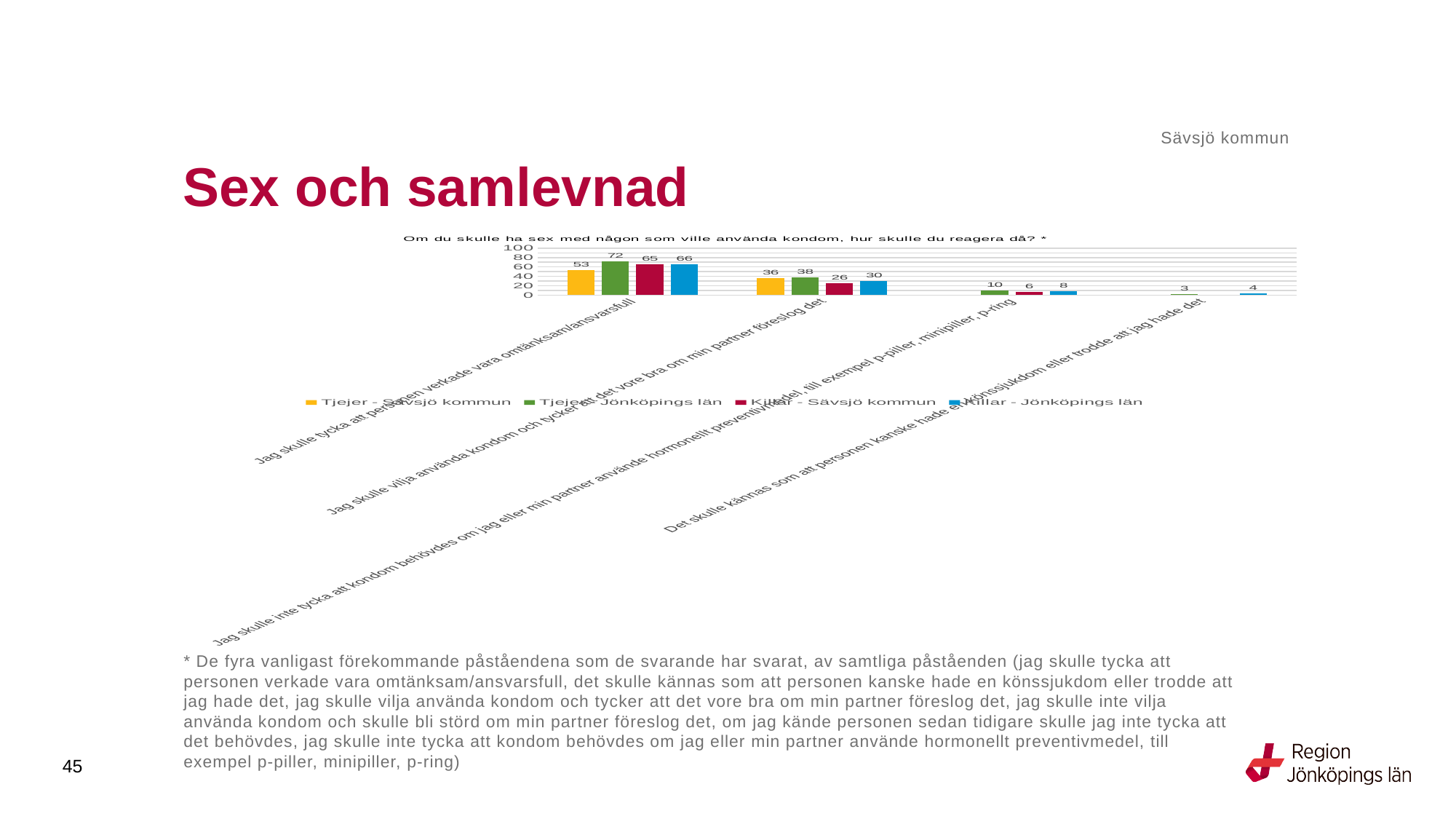
Which series has the highest value for the category "Jag skulle tycka att personen verkade vara omtänksam/ansvarsfull"? Tjejer - Jönköpings län How many series does the legend list? 4 What is the difference between Tjejer - Jönköpings län and Tjejer - Sävsjö kommun for the category "Jag skulle tycka att personen verkade vara omtänksam/ansvarsfull"? 19 Which is larger for the category "Jag skulle vilja använda kondom och tycker att det vore bra om min partner föreslog det": Tjejer - Sävsjö kommun or Killar - Jönköpings län? Tjejer - Sävsjö kommun Is the value for Killar - Jönköpings län for the category "Jag skulle tycka att personen verkade vara omtänksam/ansvarsfull" greater or less than 40? greater What kind of chart is shown on the slide? Bar chart Which series has the lowest value for the category "Jag skulle vilja använda kondom och tycker att det vore bra om min partner föreslog det"? Killar - Sävsjö kommun What value is shown for Killar - Jönköpings län for the category "Det skulle kännas som att personen kanske hade en könssjukdom eller trodde att jag hade det"? 4 What value is shown for Tjejer - Jönköpings län for the category "Jag skulle tycka att personen verkade vara omtänksam/ansvarsfull"? 72 What colour represents Killar - Sävsjö kommun in the chart? Red What value is shown for Tjejer - Sävsjö kommun for the category "Jag skulle tycka att personen verkade vara omtänksam/ansvarsfull"? 53 What value is shown for Killar - Sävsjö kommun for the category "Jag skulle vilja använda kondom och tycker att det vore bra om min partner föreslog det"? 26